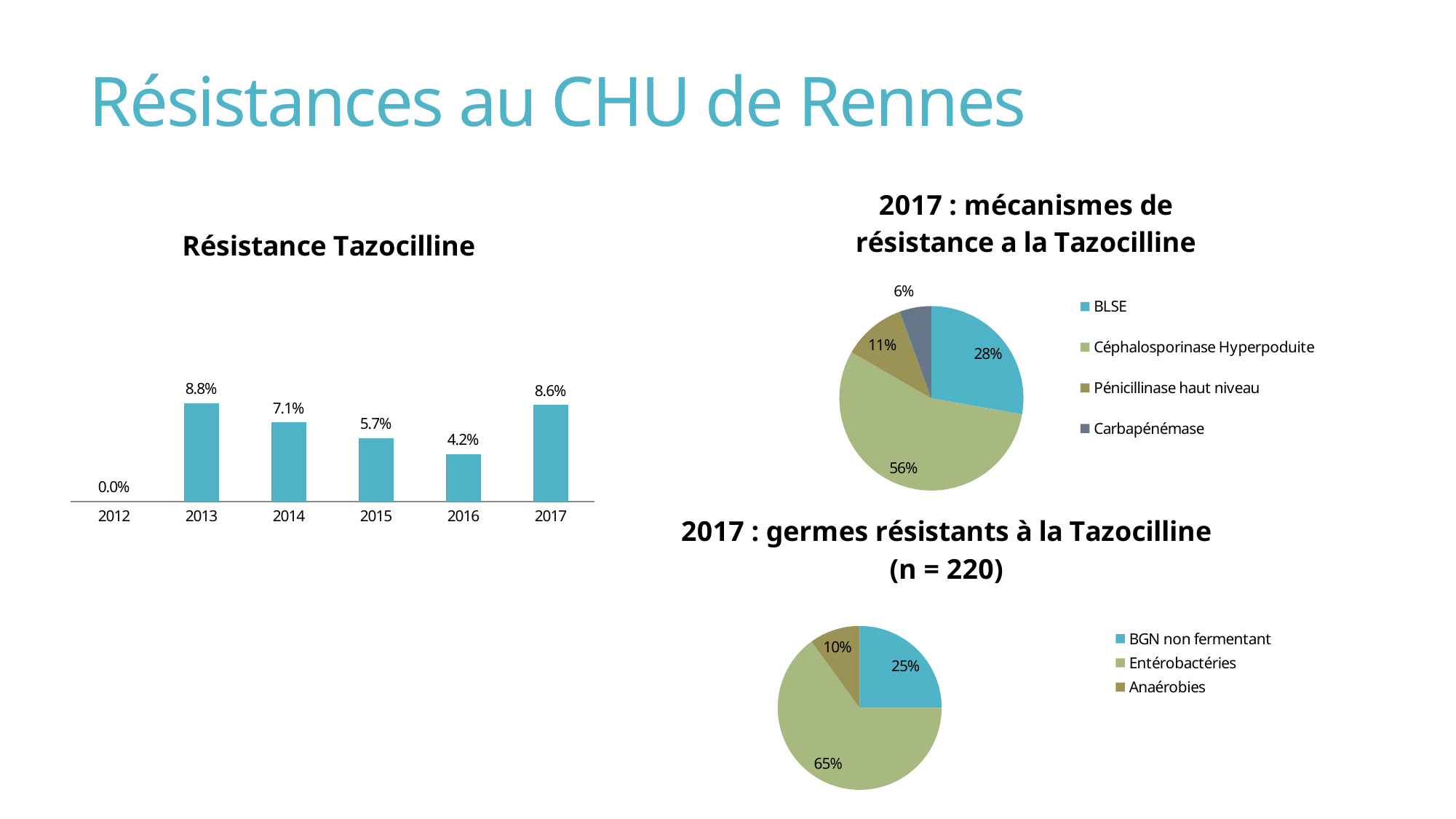
In the 'Résistance Tazocilline' chart, which year has the lowest value? 2012 How many years are shown in the 'Résistance Tazocilline' chart? 6 In the 'Résistance Tazocilline' chart, what is the difference between the values for 2013 and 2016? 4.6% In the 'Résistance Tazocilline' chart, what is the value for 2014? 7.1% In the 'Résistance Tazocilline' chart, do the values rise or fall from 2013 to 2016? fall In the 'Résistance Tazocilline' chart, which is larger, the value for 2015 or the value for 2017? 2017 In the '2017 : mécanismes de résistance a la Tazocilline' pie chart, which mechanism has the smallest share? Carbapénémase In the '2017 : mécanismes de résistance a la Tazocilline' pie chart, what share is Céphalosporinase Hyperpoduite? 56% How many categories does the legend of the '2017 : germes résistants à la Tazocilline (n = 220)' pie chart list? 3 In the '2017 : germes résistants à la Tazocilline (n = 220)' pie chart, what share is Entérobactéries? 65% In the 'Résistance Tazocilline' chart, which year has the highest value? 2013 What kind of chart is 'Résistance Tazocilline'? bar chart